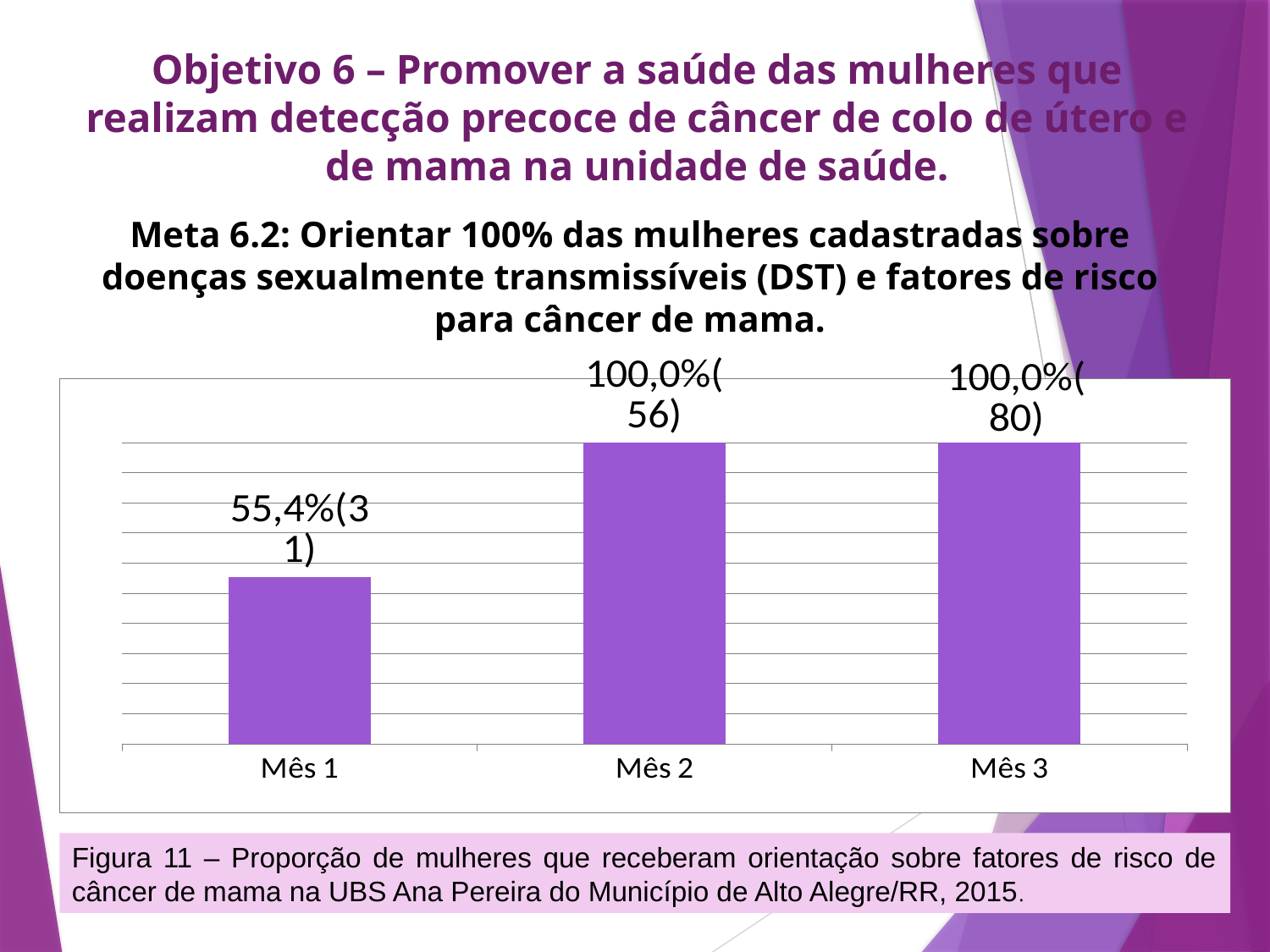
Which is larger, the value for Mês 1 or the value for Mês 2? Mês 2 What is the value shown for Mês 1? 55,4%(31) Which month has the lowest value? Mês 1 Do the values rise or fall from Mês 1 to Mês 3? Rise What is the value shown for Mês 3? 100,0%(80) What kind of chart is shown on the slide? Bar chart What is the difference in percentage between Mês 2 and Mês 1? 44,6% What percentage is shown for Mês 1? 55,4% What is the value shown for Mês 2? 100,0%(56) How many women are shown in parentheses for Mês 3? 80 What figure number is given in the caption below the chart? Figura 11 How many categories are shown on the x axis? 3